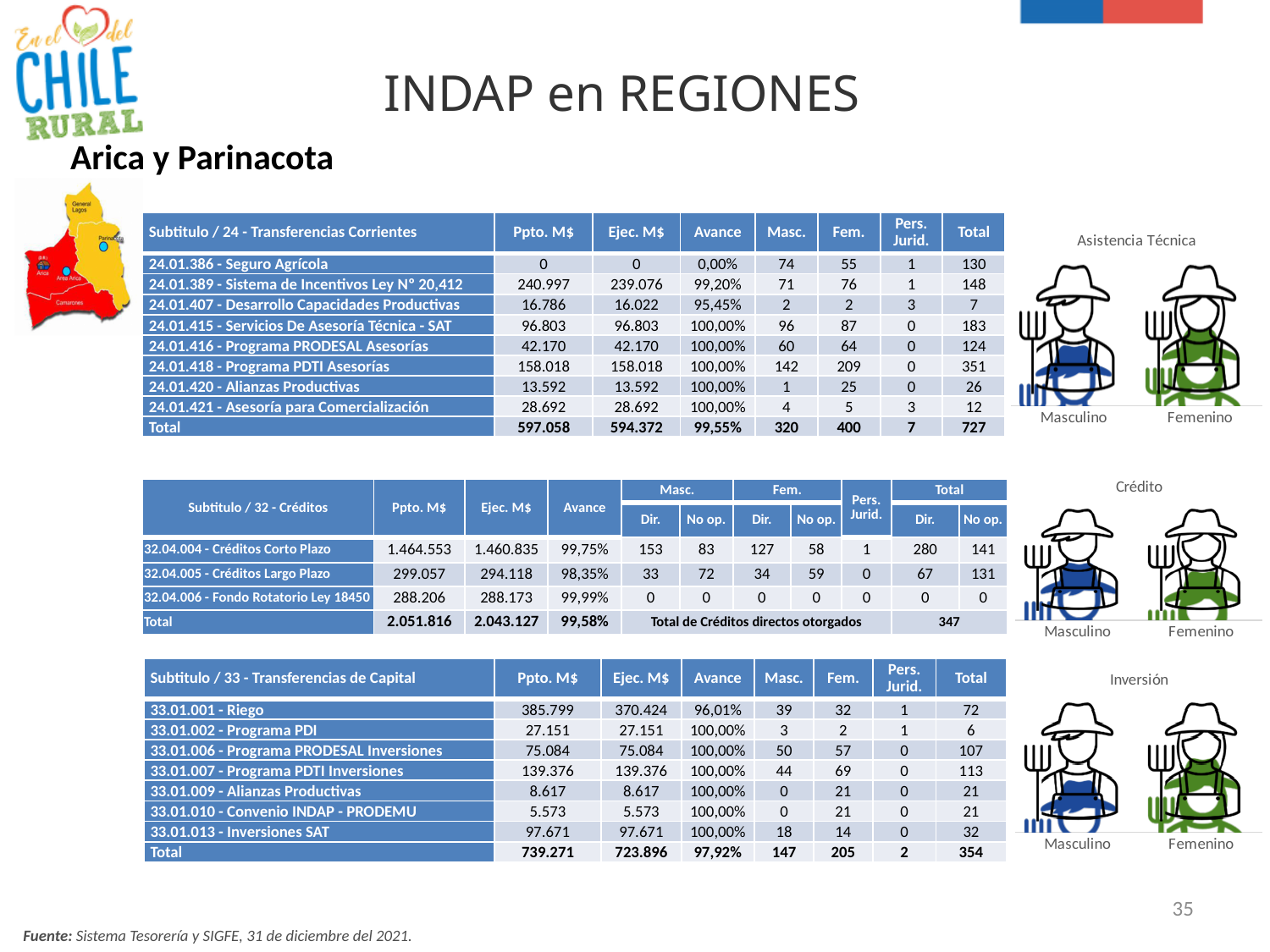
In the Crédito pictogram chart, which figure is filled higher, Masculino or Femenino? Masculino In the Inversión pictogram chart, which figure is filled higher, Masculino or Femenino? Femenino How many pictogram charts are shown on the right side of the slide? 3 In the Asistencia Técnica pictogram chart, which figure is filled higher, Masculino or Femenino? Femenino How many categories does the Asistencia Técnica pictogram chart show? 2 In the pictogram charts, which colour is used for the Femenino figure? green What kind of chart is used to show Asistencia Técnica by gender on the right of the slide? pictogram (icon chart) What are the two categories shown in the Crédito pictogram chart? Masculino and Femenino